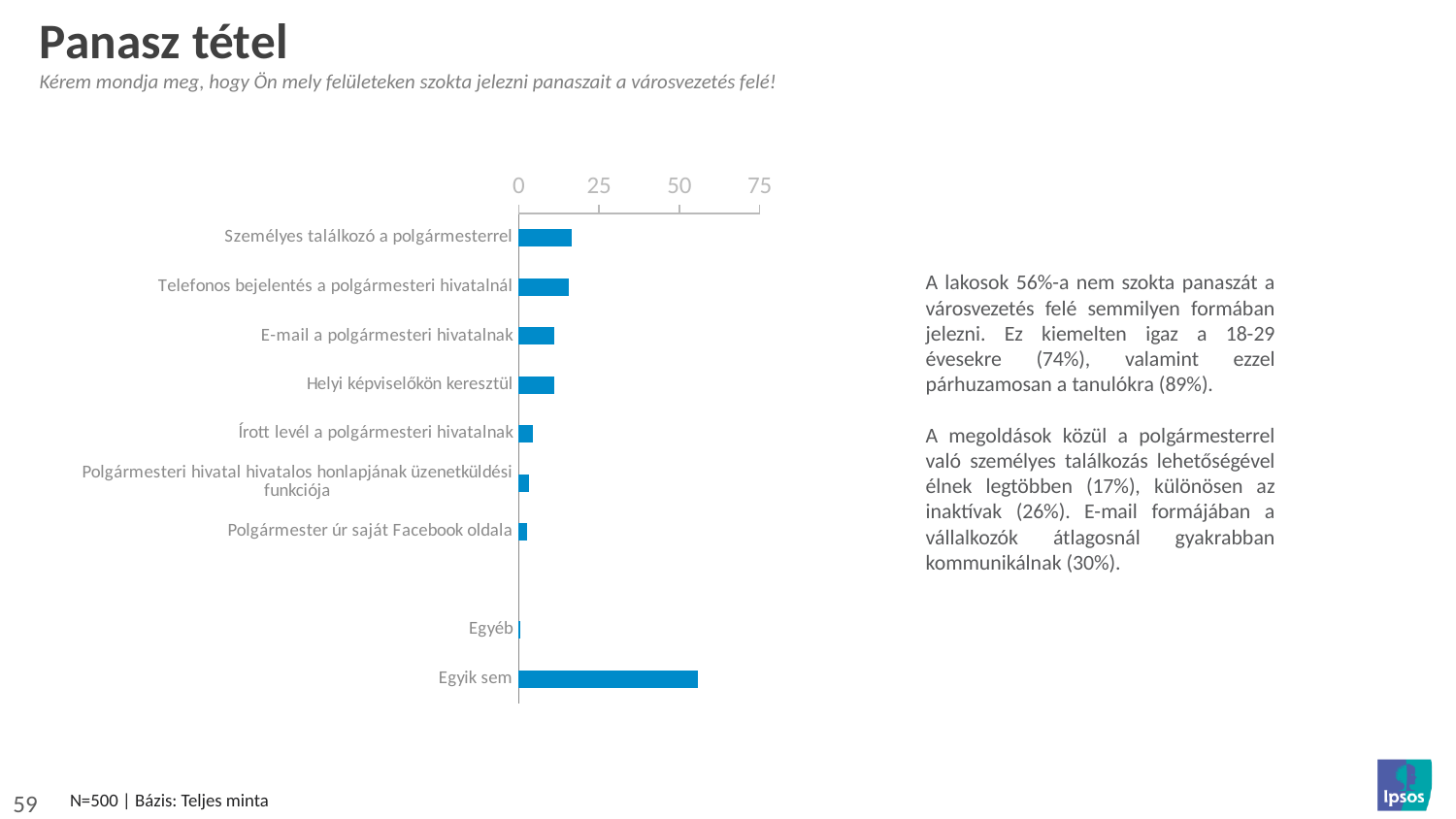
Is the value for Egyik sem greater or less than 75? less How many categories are plotted in the chart? 9 Which is larger: the value for Egyik sem or the value for Személyes találkozó a polgármesterrel? Egyik sem What is the title of the slide containing the chart? Panasz tétel Which category has the lowest value in the chart? Egyéb Which category has the highest value in the chart? Egyik sem Is the value for Személyes találkozó a polgármesterrel greater or less than 25? less What kind of chart is shown on the slide? bar chart Which is larger: the value for Személyes találkozó a polgármesterrel or the value for Írott levél a polgármesteri hivatalnak? Személyes találkozó a polgármesterrel Is the value for Egyik sem greater or less than 50? greater Which is larger: the value for Telefonos bejelentés a polgármesteri hivatalnál or the value for Polgármester úr saját Facebook oldala? Telefonos bejelentés a polgármesteri hivatalnál